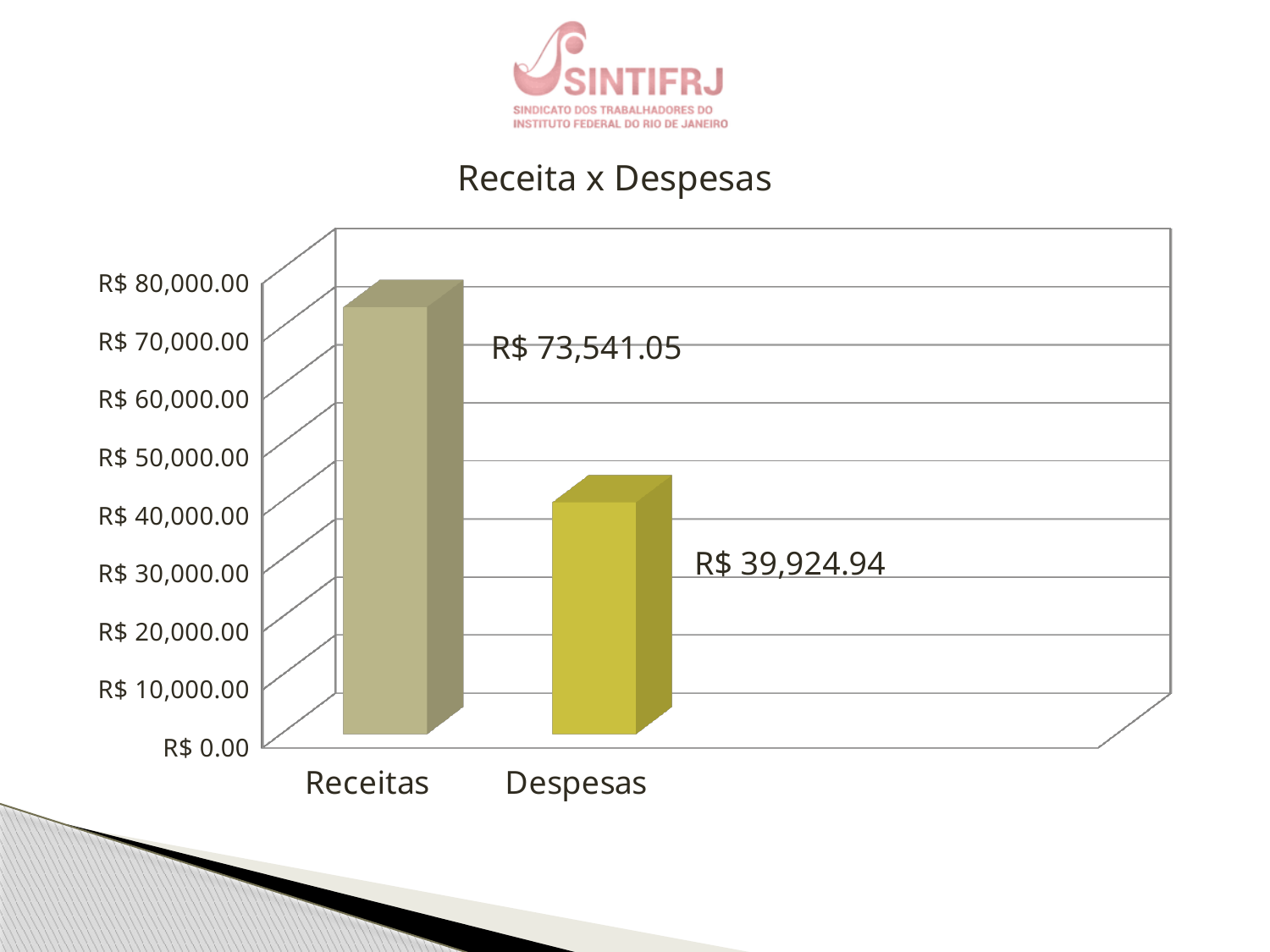
What is the title of the chart? Receita x Despesas What is the difference between Receitas and Despesas? R$ 33,616.11 What is the highest value shown on the vertical axis? R$ 80,000.00 Is the value for Despesas greater or less than R$ 50,000.00? less Which category has the lowest value? Despesas What is the value for Despesas? R$ 39,924.94 Which category has the highest value? Receitas Which is larger, Receitas or Despesas? Receitas What is the value for Receitas? R$ 73,541.05 How many categories are shown in the chart? 2 What kind of chart is shown on the slide? bar chart Is the value for Receitas greater or less than R$ 60,000.00? greater